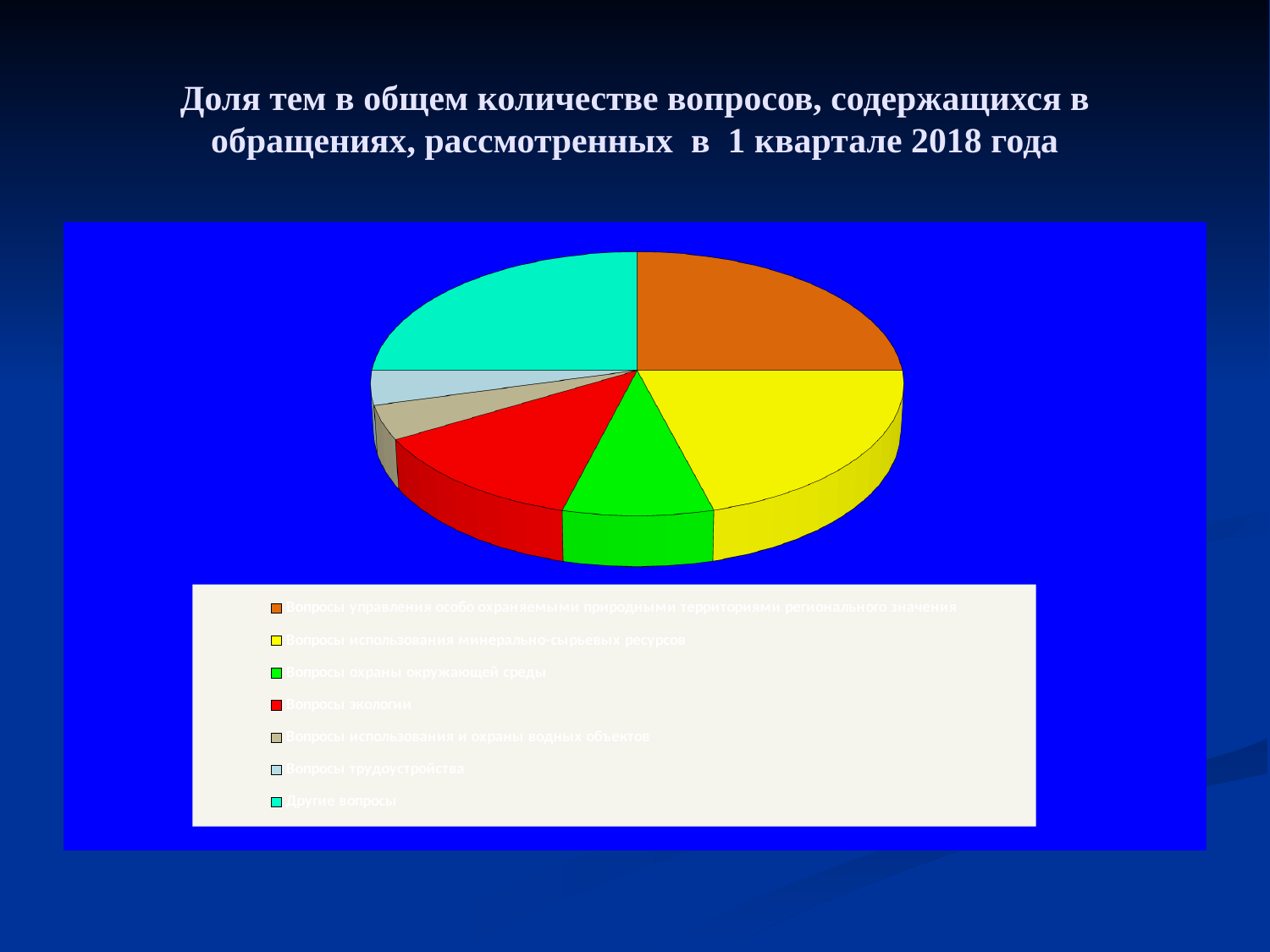
How many slices does the pie chart have? 7 What is the title of the chart on the slide? Доля тем в общем количестве вопросов, содержащихся в обращениях, рассмотренных в 1 квартале 2018 года Which slice is larger: Вопросы использования минерально-сырьевых ресурсов or Вопросы охраны окружающей среды? Вопросы использования минерально-сырьевых ресурсов Which slice is larger: Вопросы экологии or Вопросы использования и охраны водных объектов? Вопросы экологии What kind of chart is shown on the slide? pie chart What colour is the slice for Вопросы экологии? red Which slice is larger: Вопросы охраны окружающей среды or Вопросы использования и охраны водных объектов? Вопросы охраны окружающей среды